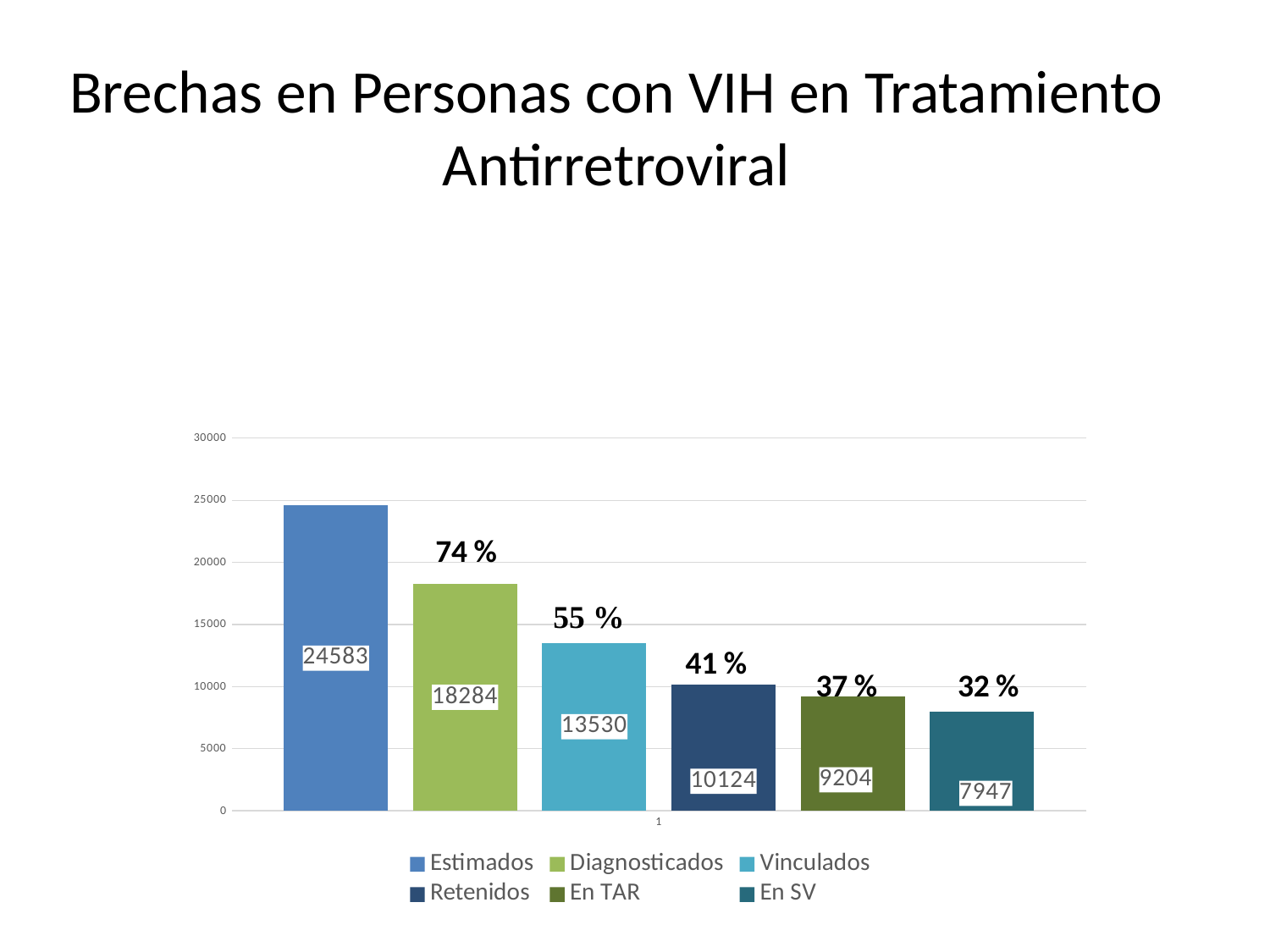
What percentage label is shown above the Vinculados bar? 55 % What is the value for Diagnosticados? 18284 How many series does the legend list? 6 What kind of chart is shown on the slide? Bar chart What is the value for Retenidos? 10124 What is the value for Estimados? 24583 What is the difference between the values for Estimados and Diagnosticados? 6299 Which series has the highest value? Estimados Which is larger, the value for Vinculados or the value for Retenidos? Vinculados Which series has the lowest value? En SV What is the value for En SV? 7947 What is the difference between the values for En TAR and En SV? 1257